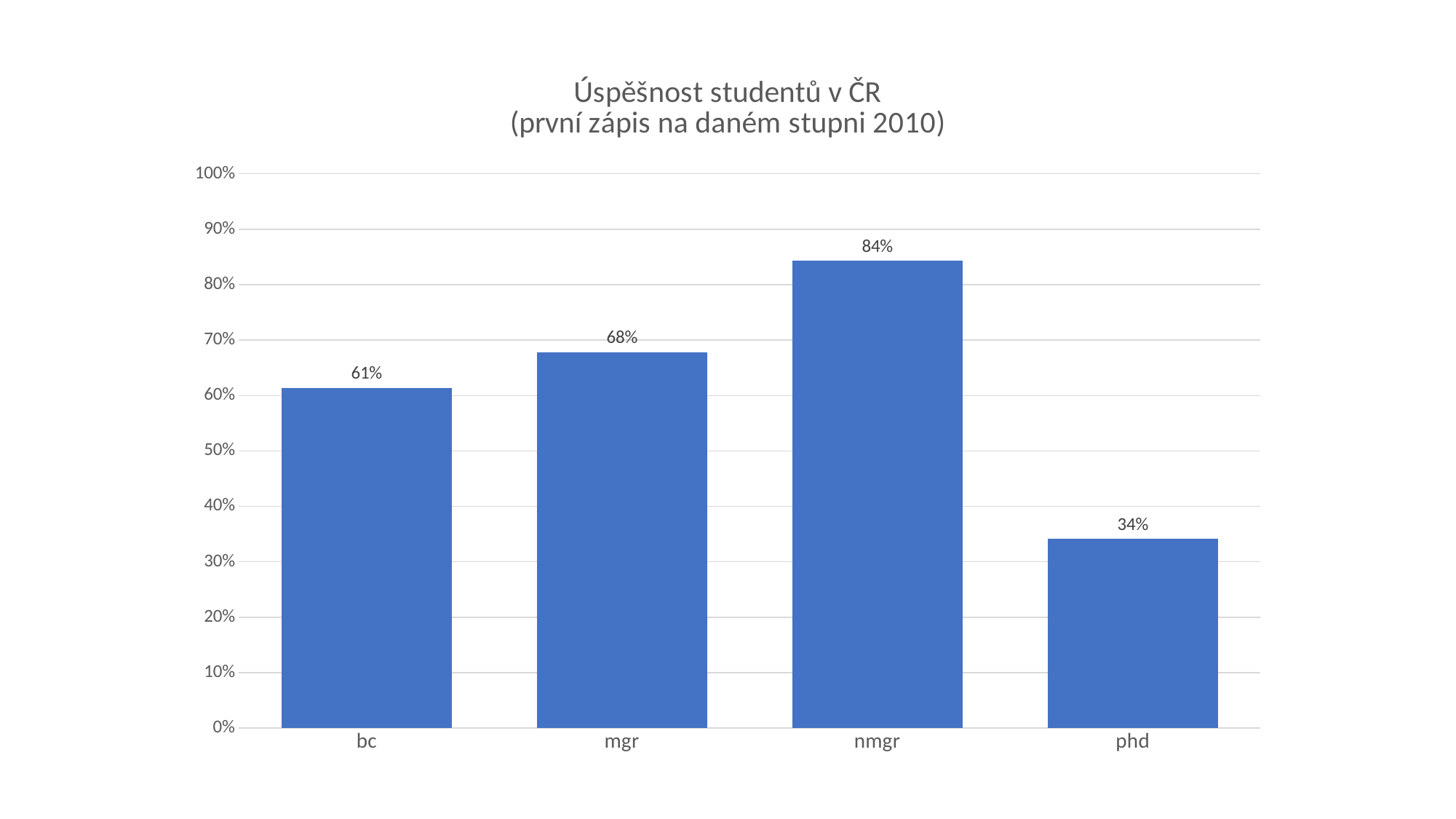
What is the value for phd? 34% What is the value for bc? 61% What is the difference between the values for nmgr and phd? 50% How many categories are shown on the x axis? 4 Which category has the highest value? nmgr What is the difference between the values for mgr and bc? 7% Which category has the lowest value? phd What kind of chart is this? bar chart What is the value for mgr? 68% What is the value for nmgr? 84% What is the title of the chart? Úspěšnost studentů v ČR (první zápis na daném stupni 2010) Which is larger, the value for bc or the value for mgr? mgr